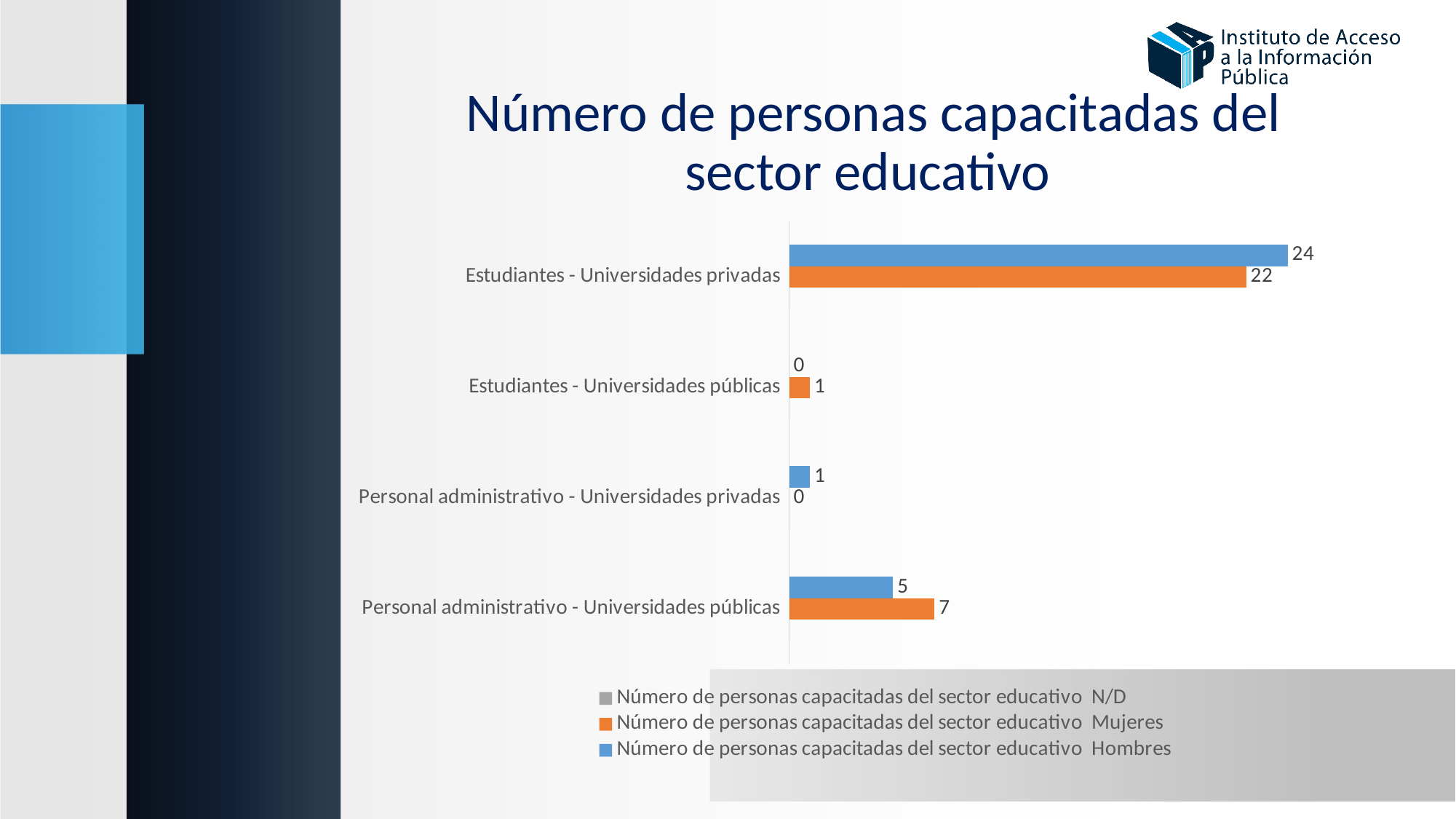
What is the value for Hombres in the Estudiantes - Universidades públicas category? 0 How many series does the legend list? 3 What is the value for Hombres in the Estudiantes - Universidades privadas category? 24 What is the value for Mujeres in the Estudiantes - Universidades privadas category? 22 Which category has the lowest value for Mujeres? Personal administrativo - Universidades privadas What kind of chart is shown on the slide? Bar chart Which category has the highest value for Hombres? Estudiantes - Universidades privadas In the Personal administrativo - Universidades públicas category, which is larger, Hombres or Mujeres? Mujeres What is the value for Hombres in the Personal administrativo - Universidades públicas category? 5 What is the value for Mujeres in the Personal administrativo - Universidades públicas category? 7 How many categories are shown on the chart? 4 What is the difference between the Hombres and Mujeres values for Estudiantes - Universidades privadas? 2